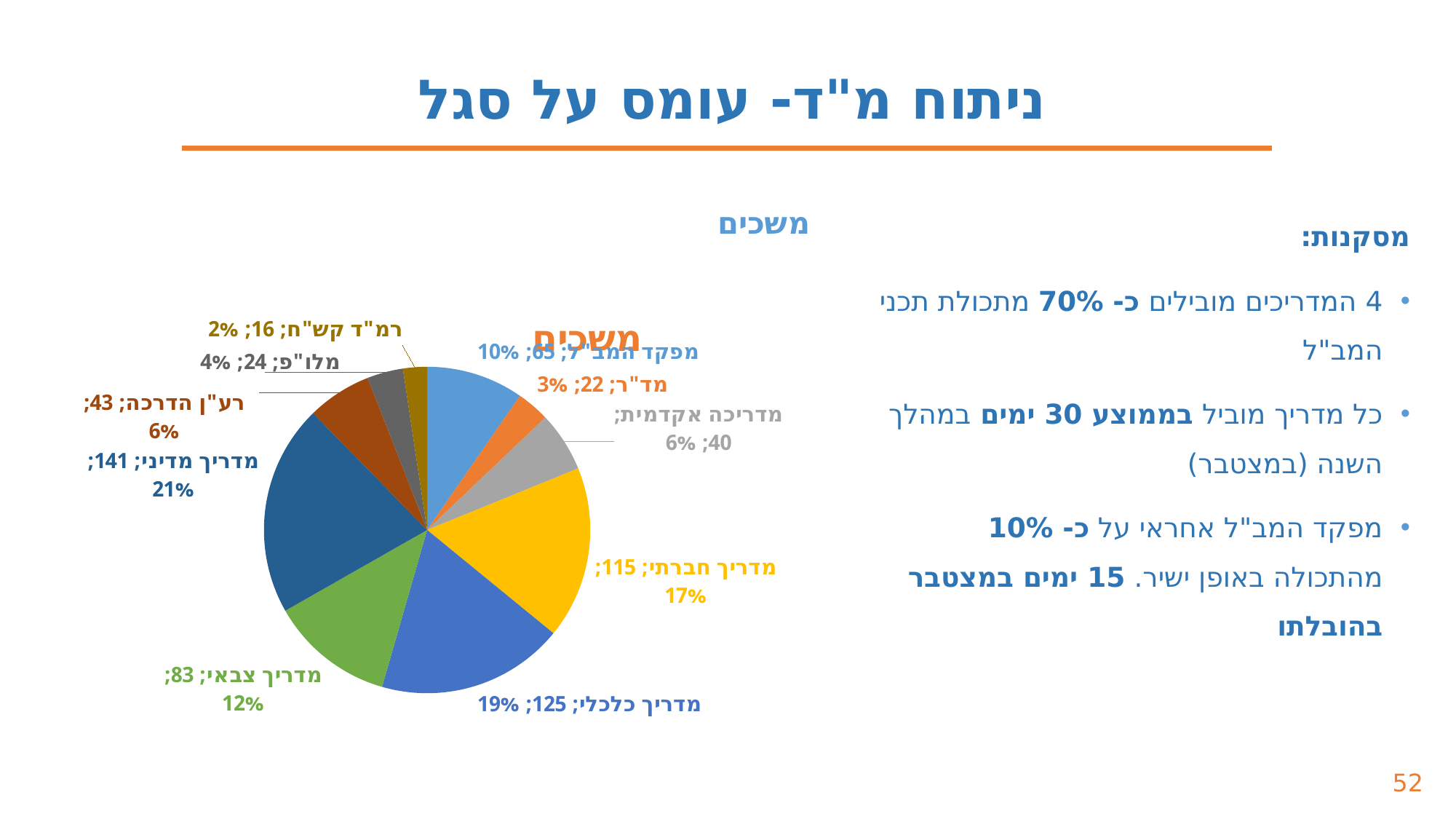
What is the value shown for מדריך מדיני? 141 What is the difference between the values for מדריך מדיני and מדריך כלכלי? 16 What is the value shown for מלו"פ? 24 How many slices does the pie chart have? 10 Which is larger, the value for מדריך צבאי or the value for מדריכה אקדמית? מדריך צבאי What is the value shown for מדריך חברתי? 115 What kind of chart is shown on the slide? pie chart What is the title of the pie chart? משכים What percentage share does מדריך כלכלי have in the pie chart? 19% Which category has the smallest slice in the pie chart? רמ"ד קש"ח Which category has the largest slice in the pie chart? מדריך מדיני What percentage share does מפקד המב"ל have in the pie chart? 10%